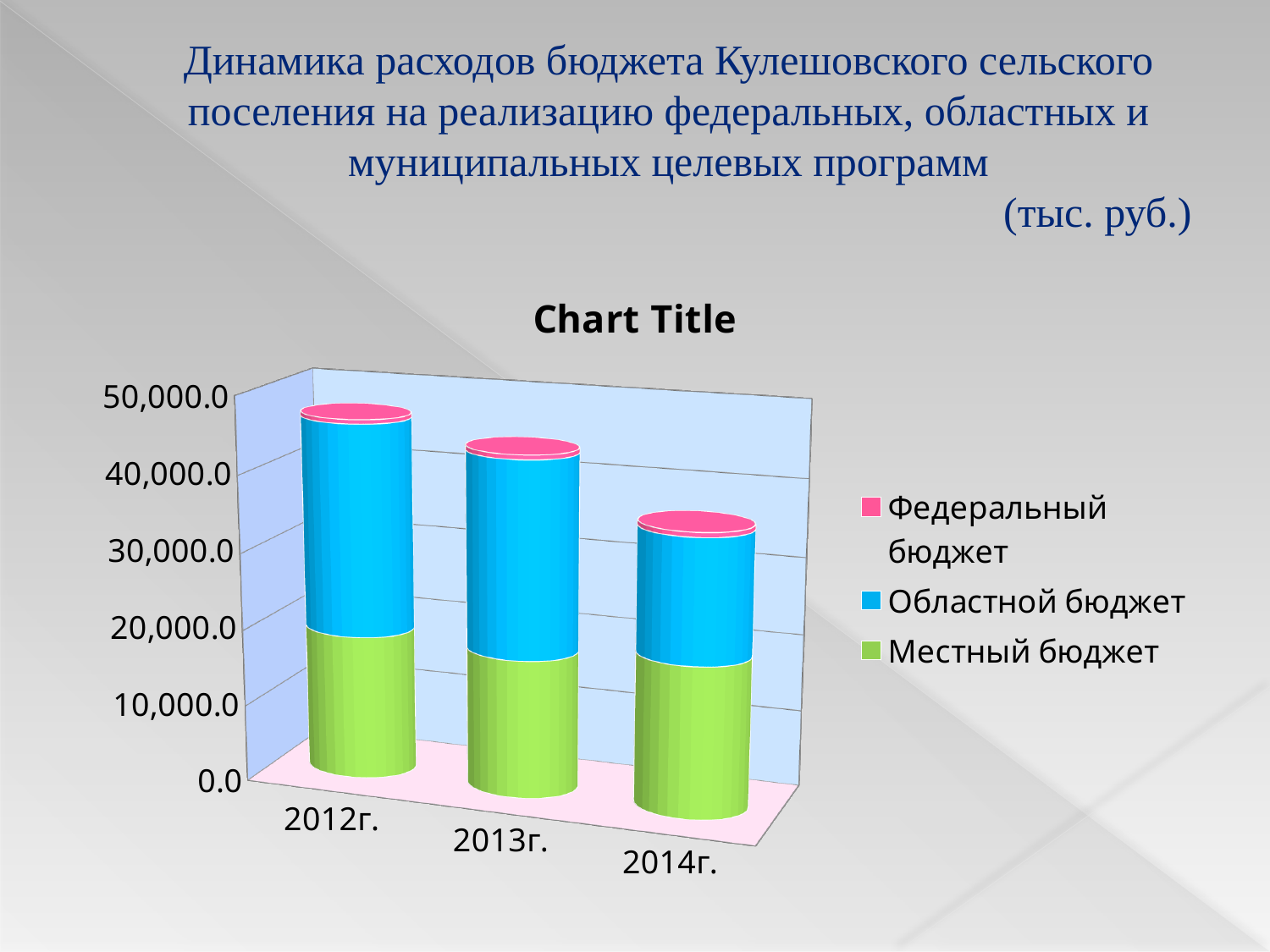
How many series does the chart legend list? 3 Do the total bar heights rise or fall from 2012г. to 2014г.? fall How many years (categories) are shown on the x axis of the chart? 3 What title is printed above the chart? Chart Title Is the total value for 2012г. greater or less than 40,000.0? greater Which year has the highest total stacked bar? 2012г. Is the total value for 2014г. greater or less than 40,000.0? less Which is larger, the total bar for 2012г. or the total bar for 2014г.? 2012г. Which year has the lowest total stacked bar? 2014г. Is the Местный бюджет value for 2014г. greater or less than 20,000.0? less What kind of chart is shown on the slide? bar chart Which series is shown in pink in the chart legend? Федеральный бюджет